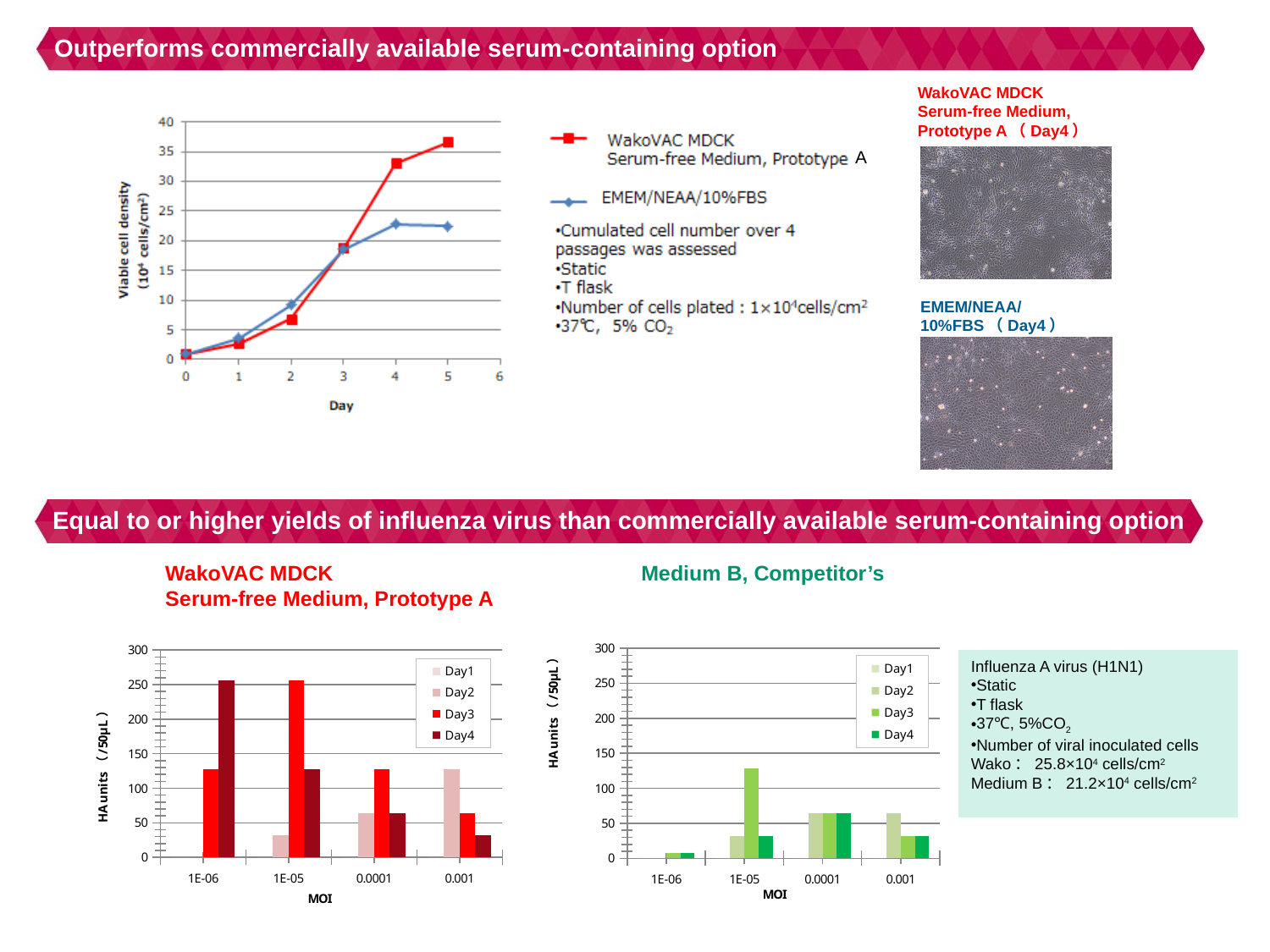
In the bottom-left WakoVAC MDCK Serum-free Medium, Prototype A chart, which day has the highest HA units at MOI 1E-05? Day3 In the top-left viable cell density chart, does the WakoVAC MDCK Serum-free Medium, Prototype A series rise or fall from day 0 to day 5? rise How many MOI categories are shown on the x axis of the bottom-left WakoVAC MDCK Serum-free Medium, Prototype A chart? 4 In the top-left viable cell density chart, is the value for WakoVAC MDCK Serum-free Medium, Prototype A at day 5 greater or less than 30? greater In the bottom-right Medium B, Competitor's chart, which is larger at MOI 1E-05: the Day2 value or the Day3 value? Day3 In the top-left viable cell density chart, which series has the higher value at day 5? WakoVAC MDCK Serum-free Medium, Prototype A What kind of chart is the bottom-right Medium B, Competitor's chart? bar chart How many series does the legend of the top-left viable cell density chart list? 2 In the top-left viable cell density chart, is the value for EMEM/NEAA/10%FBS at day 5 greater or less than 25? less What kind of chart is the top-left chart showing viable cell density against day? line chart In the bottom-left WakoVAC MDCK Serum-free Medium, Prototype A chart, is the Day4 value at MOI 1E-06 greater or less than 200? greater How many series does the legend of the bottom-left WakoVAC MDCK Serum-free Medium, Prototype A chart list? 4